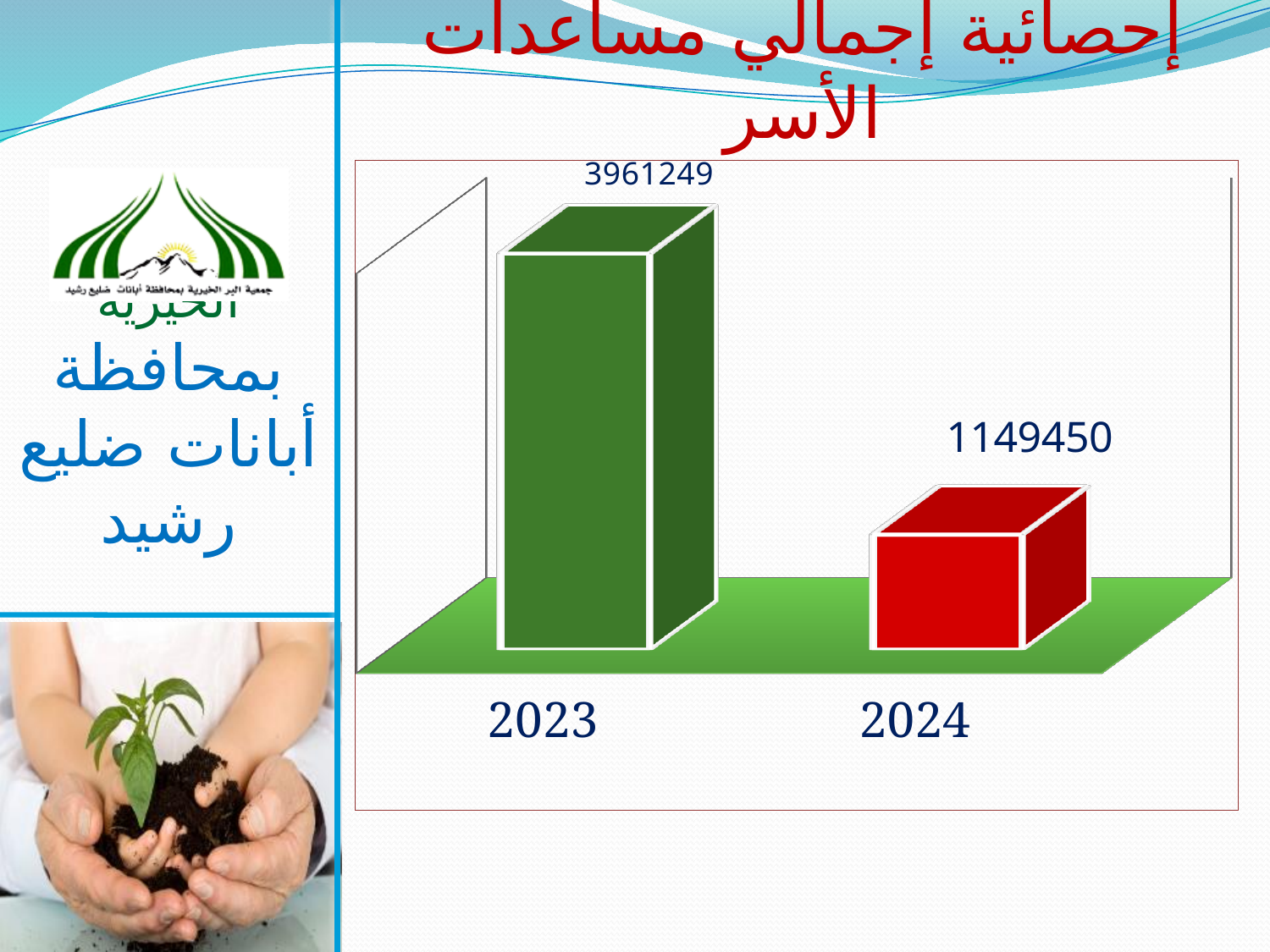
Do the values rise or fall from 2023 to 2024? fall What kind of chart is shown on the slide? bar chart What is the value for 2023? 3961249 Which year has the highest value? 2023 What colour is the bar for 2024? red What colour is the bar for 2023? green What is the value for 2024? 1149450 Which year has the lowest value? 2024 What is the difference between the values for 2023 and 2024? 2811799 Which is larger, the value for 2023 or the value for 2024? 2023 How many categories are shown on the x axis? 2